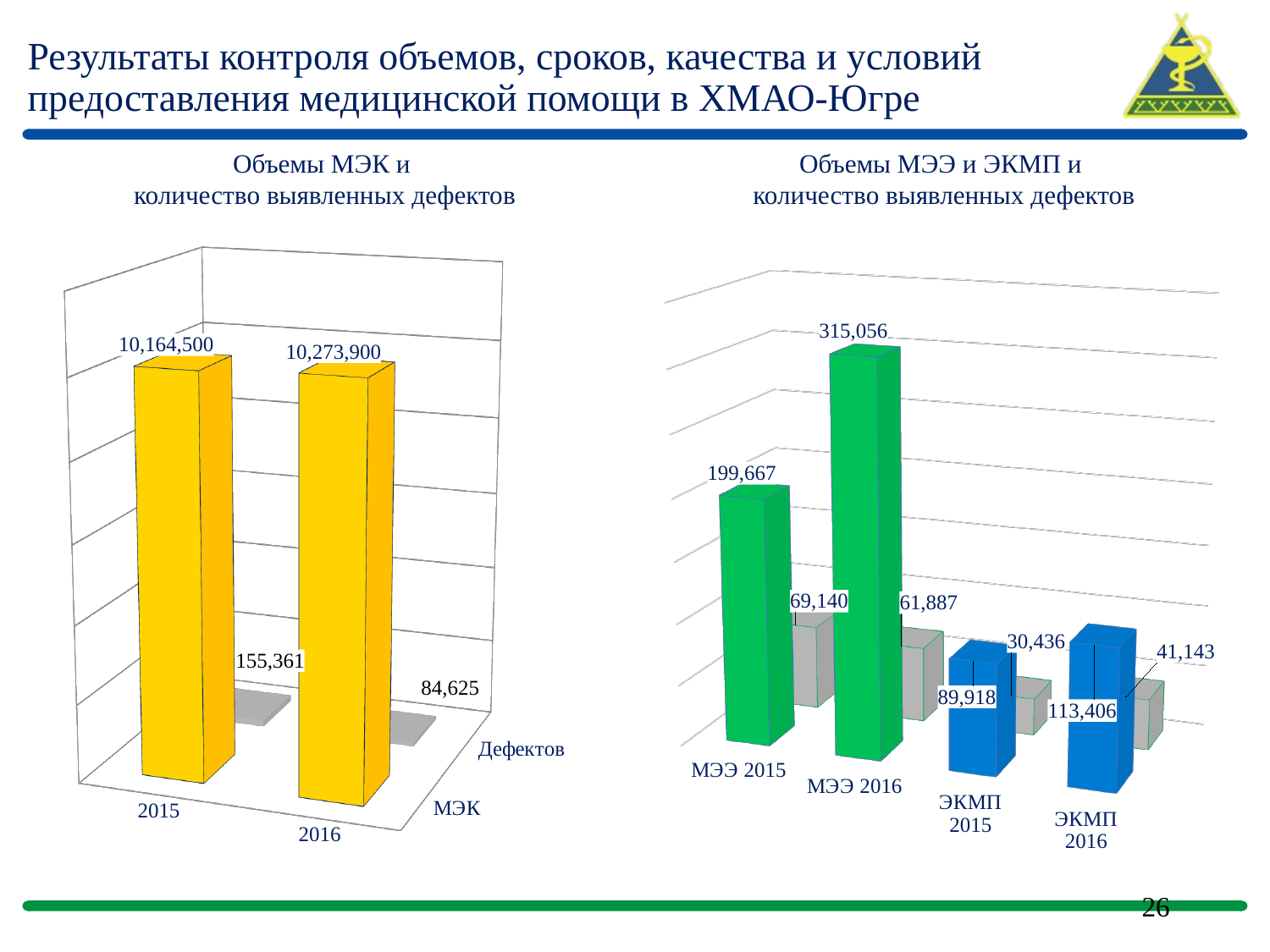
In the right chart (Объемы МЭЭ и ЭКМП и количество выявленных дефектов), which category has the lowest volume value? ЭКМП 2015 In the right chart (Объемы МЭЭ и ЭКМП и количество выявленных дефектов), which category has the highest volume value? МЭЭ 2016 In the left chart (Объемы МЭК и количество выявленных дефектов), what is the difference between the Дефектов values for 2015 and 2016? 70,736 In the left chart (Объемы МЭК и количество выявленных дефектов), by how much did the МЭК value increase from 2015 to 2016? 109,400 In the left chart (Объемы МЭК и количество выявленных дефектов), what is the Дефектов value for 2015? 155,361 In the right chart (Объемы МЭЭ и ЭКМП и количество выявленных дефектов), what is the volume value for МЭЭ 2016? 315,056 In the right chart (Объемы МЭЭ и ЭКМП и количество выявленных дефектов), how many categories are shown on the x axis? 4 In the right chart (Объемы МЭЭ и ЭКМП и количество выявленных дефектов), what is the difference between the volume values for МЭЭ 2016 and МЭЭ 2015? 115,389 In the left chart (Объемы МЭК и количество выявленных дефектов), did the Дефектов value rise or fall from 2015 to 2016? fall What type of chart is the left chart (Объемы МЭК и количество выявленных дефектов)? bar chart In the right chart (Объемы МЭЭ и ЭКМП и количество выявленных дефектов), what is the number of defects for ЭКМП 2016? 41,143 In the left chart (Объемы МЭК и количество выявленных дефектов), what is the МЭК value for 2016? 10,273,900